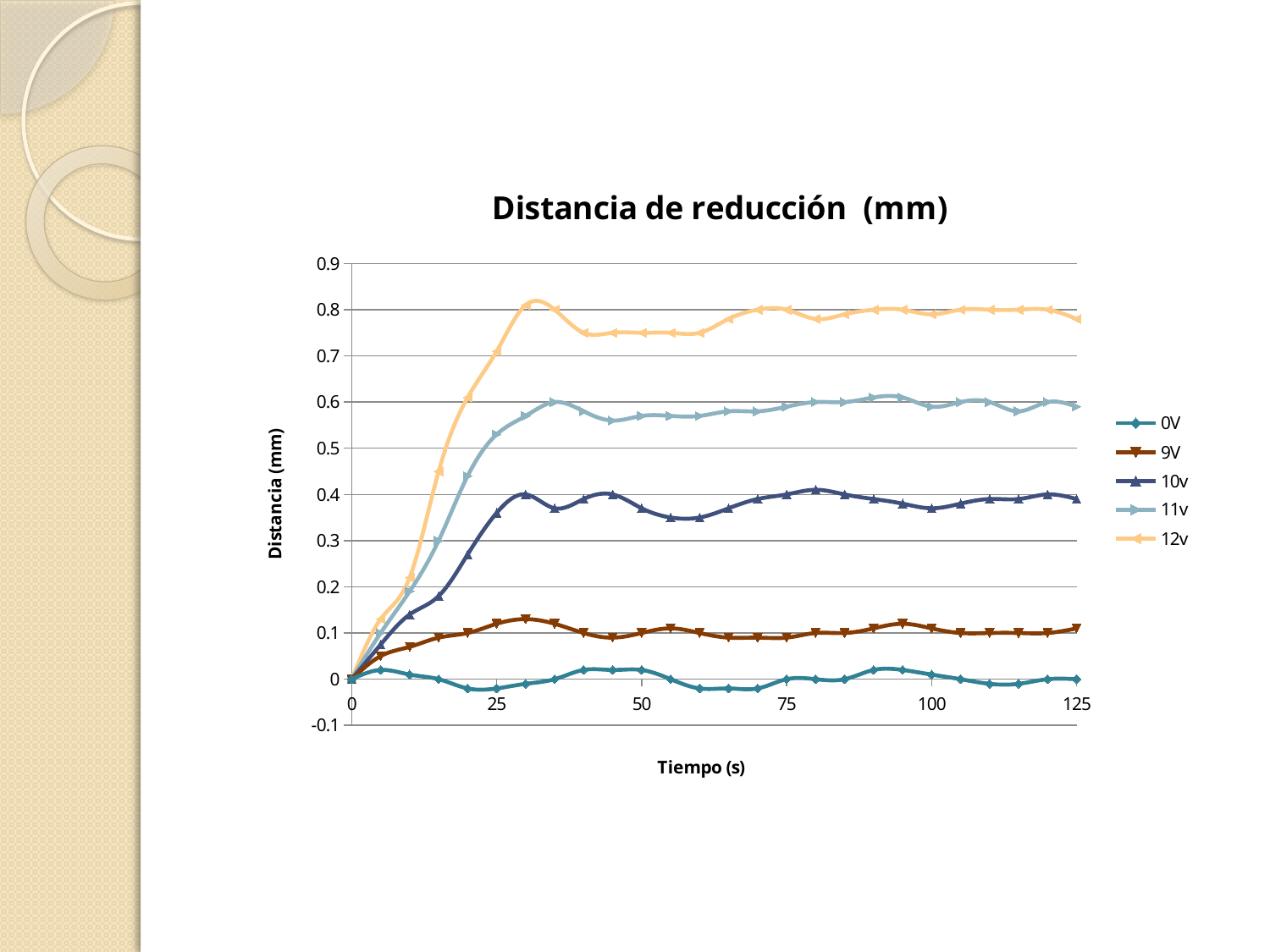
Is the value for 12v at 100 s greater or less than 0.7? greater Which series reaches the highest values on the chart? 12v Is the value for 11v at 50 s greater or less than 0.5? greater What is the label of the x axis? Tiempo (s) What kind of chart is shown on the slide? line chart Which series stays lowest across the chart? 0V How many series does the legend list? 5 At 100 s, which series has the larger value, 11v or 10v? 11v Does the 12v series rise or fall between 0 s and 25 s? rise What is the title of the chart? Distancia de reducción (mm) Is the value for 10v at 75 s greater or less than 0.5? less